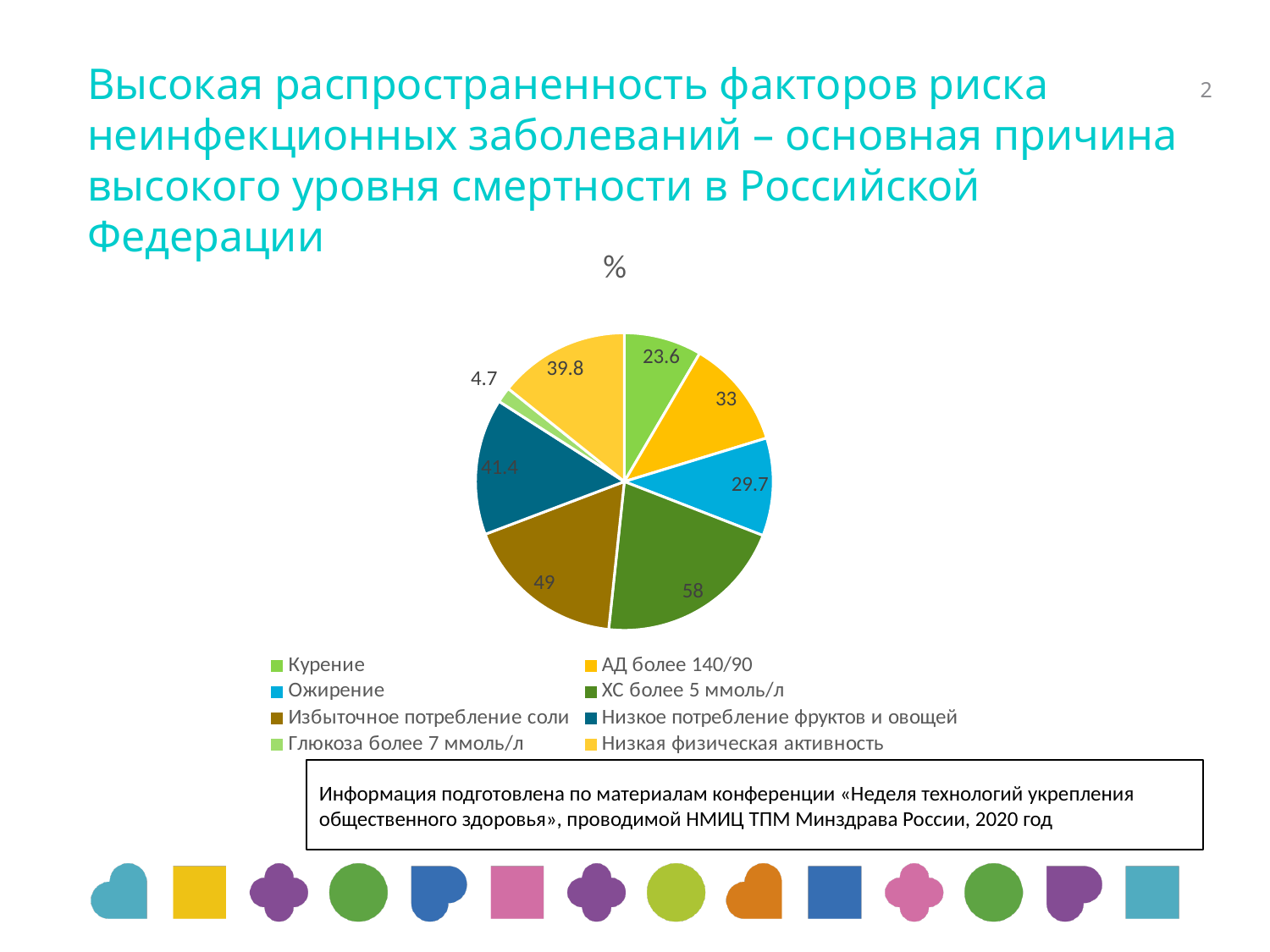
Which is larger, the value for АД более 140/90 or the value for Низкая физическая активность? Низкая физическая активность What is the title of the chart? % What is the difference between the values for Избыточное потребление соли and Ожирение? 19.3 What is the value for Низкое потребление фруктов и овощей? 41.4 What colour is the slice for Избыточное потребление соли? brown Which category has the largest value? ХС более 5 ммоль/л What is the value for Глюкоза более 7 ммоль/л? 4.7 What kind of chart is shown on the slide? pie chart Which category has the smallest value? Глюкоза более 7 ммоль/л What is the value for Курение? 23.6 What is the value for ХС более 5 ммоль/л? 58 How many categories does the pie chart show? 8